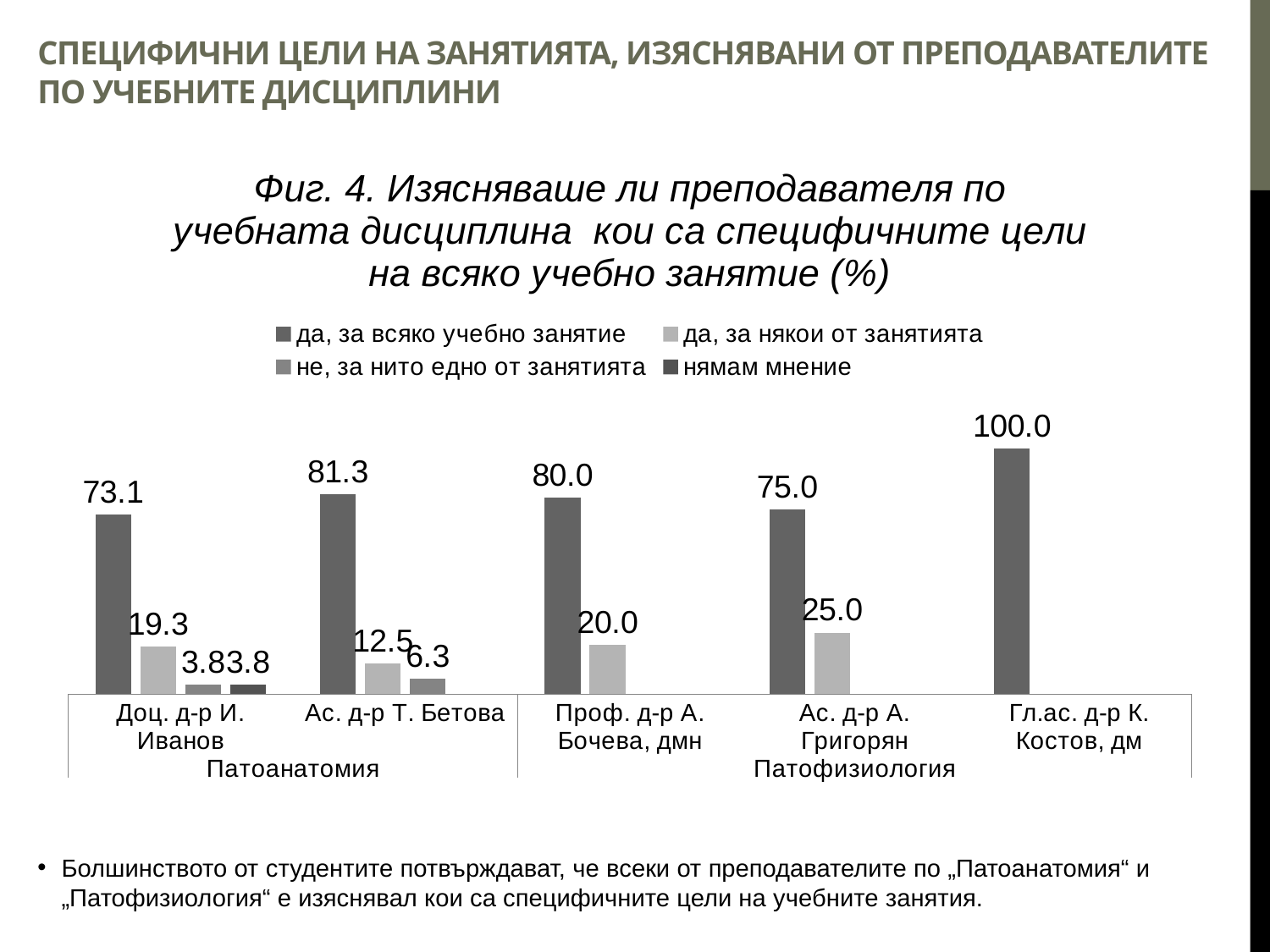
How many teachers (categories) are shown on the x axis? 5 Which two disciplines are the teachers grouped under on the x axis? Патоанатомия and Патофизиология Which teacher has the lowest value for "да, за всяко учебно занятие"? Доц. д-р И. Иванов How many series does the legend list? 4 What is the difference between the "да, за всяко учебно занятие" values for Проф. д-р А. Бочева, дмн and Ас. д-р А. Григорян? 5.0 What is the value of "да, за всяко учебно занятие" for Гл.ас. д-р К. Костов, дм? 100.0 What type of chart is shown on the slide? bar chart What is the value of "да, за всяко учебно занятие" for Ас. д-р Т. Бетова? 81.3 What is the value of "да, за някои от занятията" for Ас. д-р А. Григорян? 25.0 Which is larger: the "да, за някои от занятията" value for Проф. д-р А. Бочева, дмн or for Ас. д-р Т. Бетова? Проф. д-р А. Бочева, дмн Which teacher has the highest value for "да, за всяко учебно занятие"? Гл.ас. д-р К. Костов, дм What is the value of "да, за някои от занятията" for Доц. д-р И. Иванов? 19.3